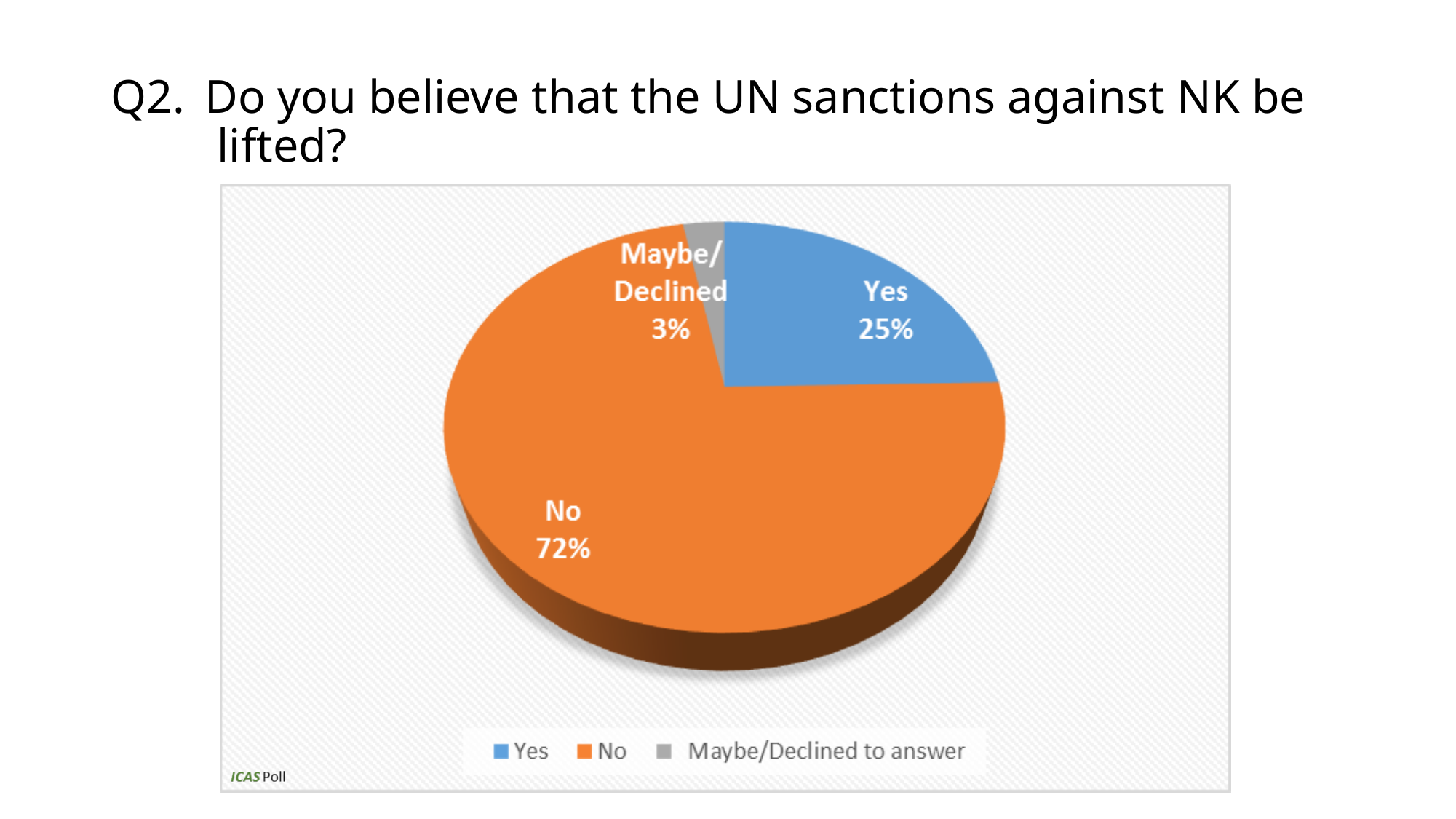
What is the difference in percentage points between the "No" and "Yes" responses? 47 What percentage of respondents answered "Maybe/Declined to answer"? 3% What percentage of respondents answered "Yes"? 25% How many entries does the legend list? 3 What colour is the "No" slice of the pie? Orange What kind of chart is shown on the slide? Pie chart How many response categories are shown in the pie chart? 3 What percentage of respondents answered "No"? 72% What is the source noted in the bottom-left corner of the chart? ICAS Poll Which response has the smallest share of the pie? Maybe/Declined to answer Which response is larger, "Yes" or "Maybe/Declined to answer"? Yes Which response has the largest share of the pie? No